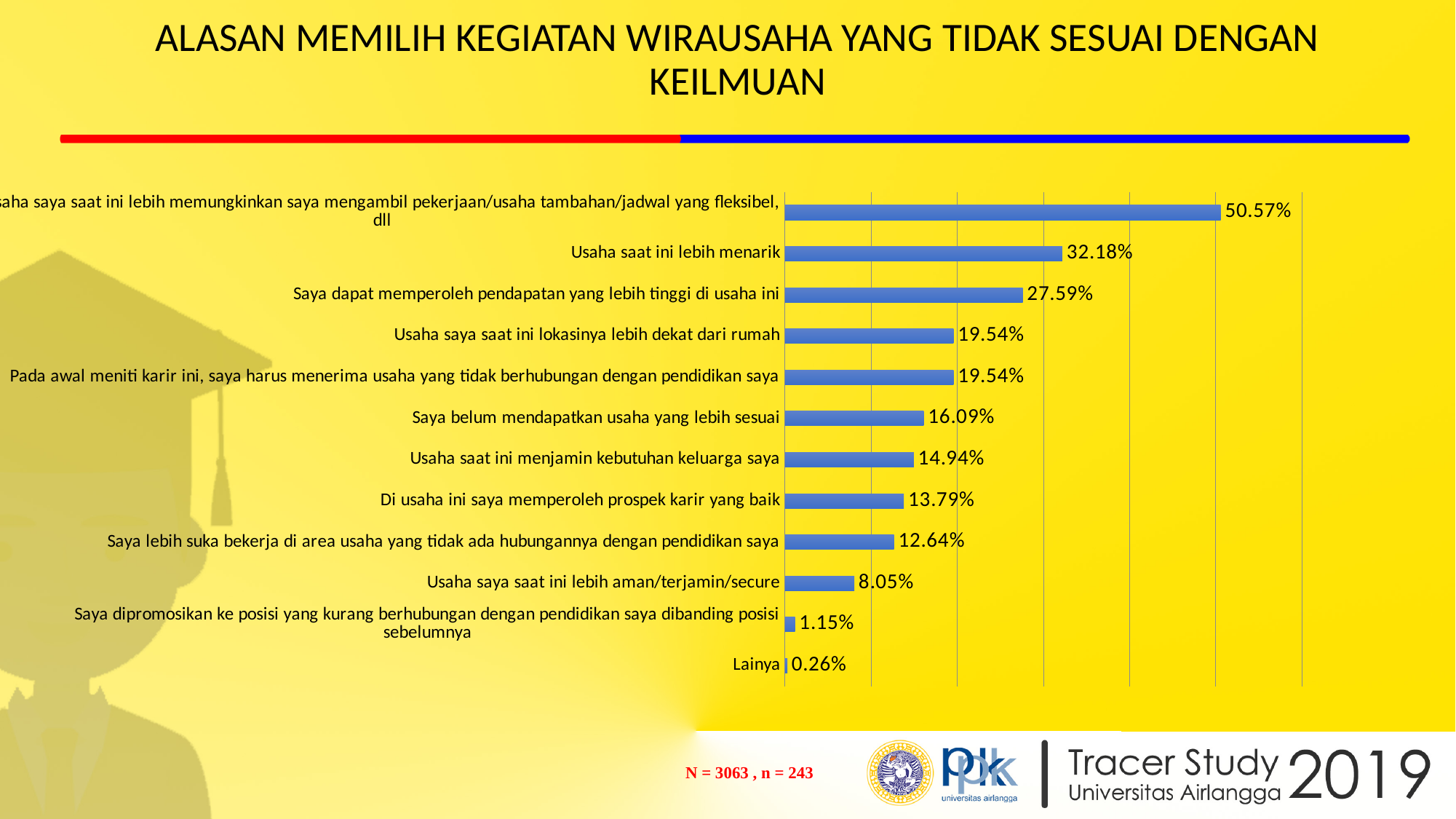
Which category has the lowest value? Lainya What is the value for "Usaha saat ini lebih menarik"? 32.18% What type of chart is shown on the slide? bar chart Which is larger: the value for "Usaha saat ini menjamin kebutuhan keluarga saya" or the value for "Di usaha ini saya memperoleh prospek karir yang baik"? Usaha saat ini menjamin kebutuhan keluarga saya What sample sizes are noted below the chart? N = 3063 , n = 243 What is the difference between the values for "Usaha saat ini lebih menarik" and "Saya dapat memperoleh pendapatan yang lebih tinggi di usaha ini"? 4.59% What is the value for "Saya belum mendapatkan usaha yang lebih sesuai"? 16.09% What is the value for "Saya lebih suka bekerja di area usaha yang tidak ada hubungannya dengan pendidikan saya"? 12.64% How many categories (bars) does the chart show? 12 What is the highest value shown in the chart? 50.57% What is the value for "Usaha saya saat ini lebih aman/terjamin/secure"? 8.05% What is the value for "Saya dapat memperoleh pendapatan yang lebih tinggi di usaha ini"? 27.59%